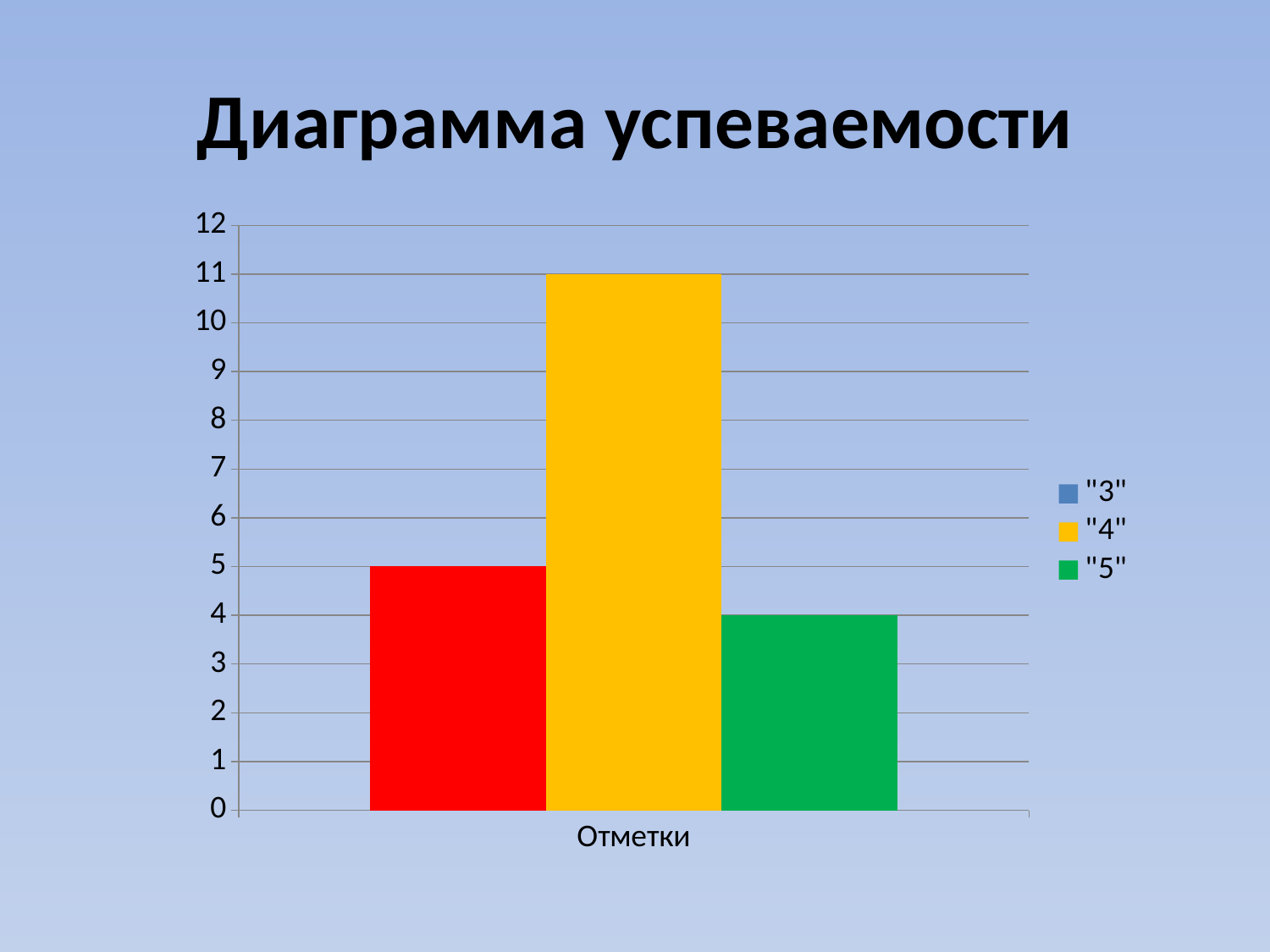
What is the value for the series "4"? 11 Is the value for "4" greater or less than 10? greater What type of chart is shown on the slide? bar chart What is the label of the category on the x axis? Отметки Which is larger, the value for "3" or the value for "5"? "3" What is the value for the series "5"? 4 What is the difference between the values for "4" and "3"? 6 What is the value for the series "3"? 5 Which series has the highest value? "4" Which series has the lowest value? "5" How many series does the legend list? 3 What is the title of the chart? Диаграмма успеваемости